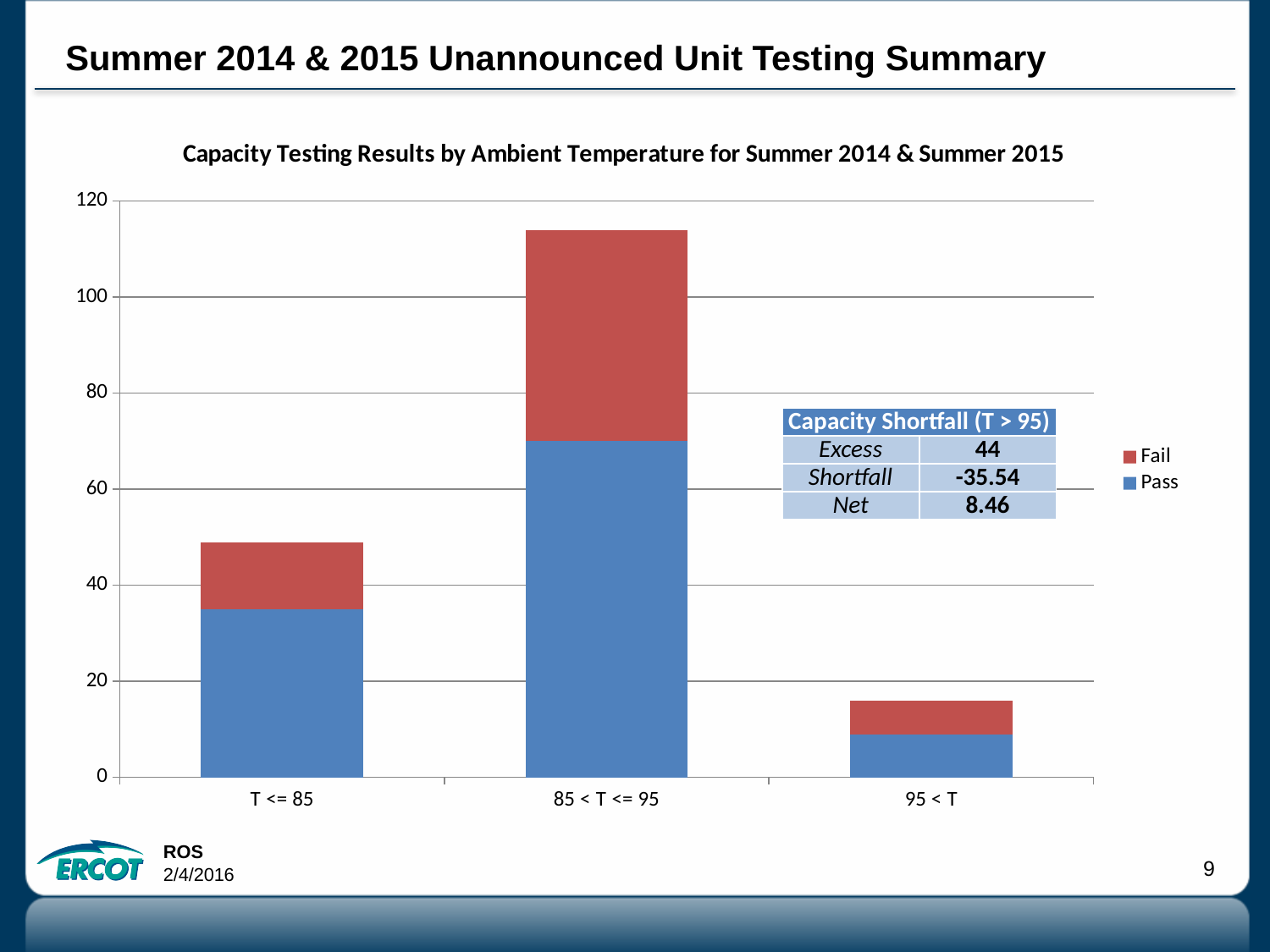
Which temperature category has the shortest stacked bar? 95 < T Is the total stacked bar for T <= 85 greater or less than 60? less Which category has a larger total bar, T <= 85 or 95 < T? T <= 85 Is the total stacked bar for 85 < T <= 95 greater or less than 100? greater How many temperature categories are shown on the x axis of the chart? 3 Is the Pass portion of the 85 < T <= 95 bar greater or less than 60? greater How many series does the chart legend list? 2 Which temperature category has the tallest stacked bar? 85 < T <= 95 Which series is shown in red in the chart legend? Fail What kind of chart is shown on the slide? stacked bar chart What is the title of the chart? Capacity Testing Results by Ambient Temperature for Summer 2014 & Summer 2015